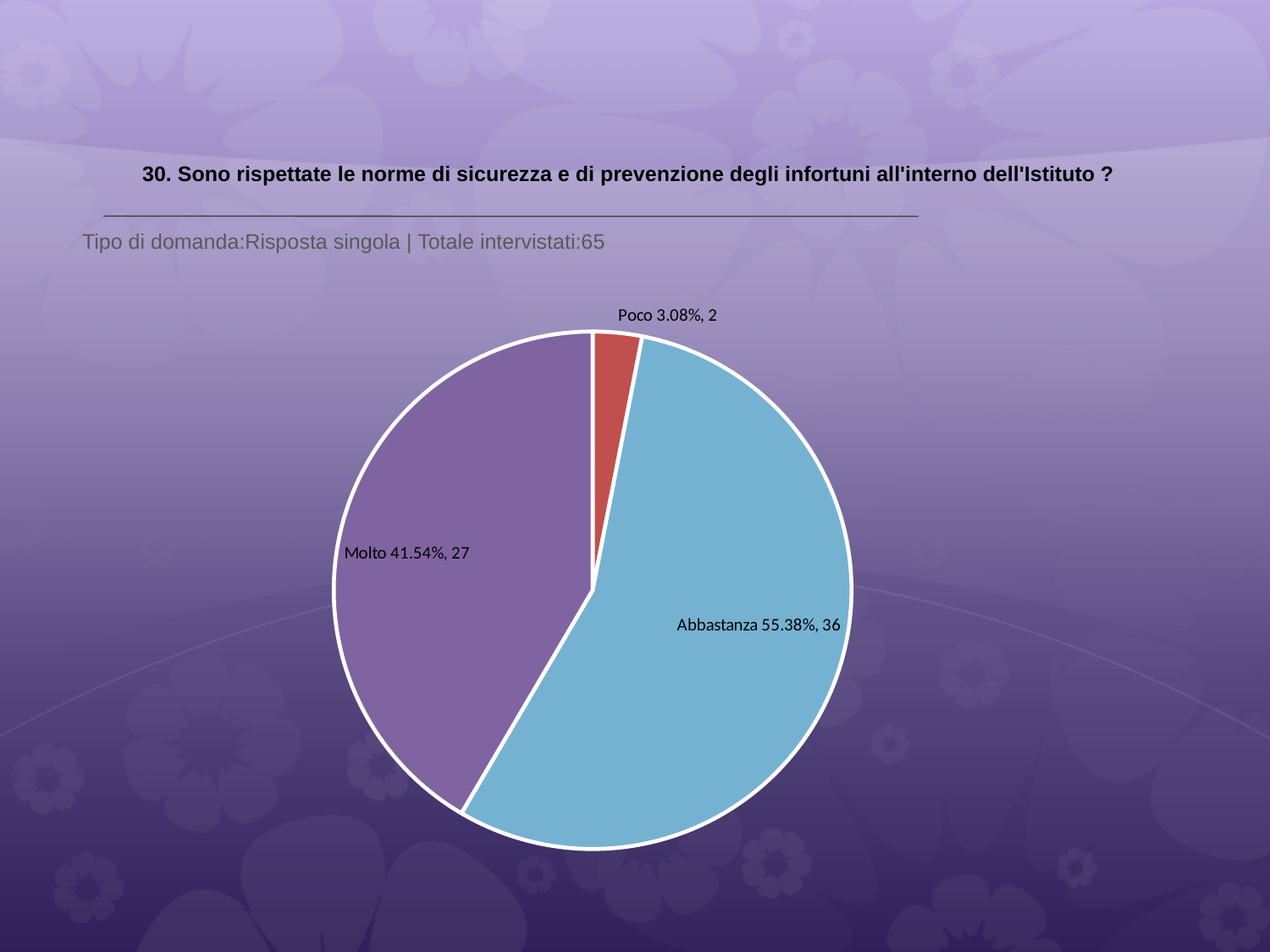
What kind of chart is shown on the slide? Pie chart What percentage share does the Molto slice have? 41.54% How many respondents answered Molto? 27 Which category has the smallest slice? Poco How many slices does the pie chart have? 3 What is the difference in respondent count between Abbastanza and Molto? 9 Which category has the largest slice? Abbastanza How many respondents answered Abbastanza? 36 Which is larger, the Molto slice or the Poco slice? Molto What percentage share does the Poco slice have? 3.08% How many respondents answered Poco? 2 What percentage share does the Abbastanza slice have? 55.38%